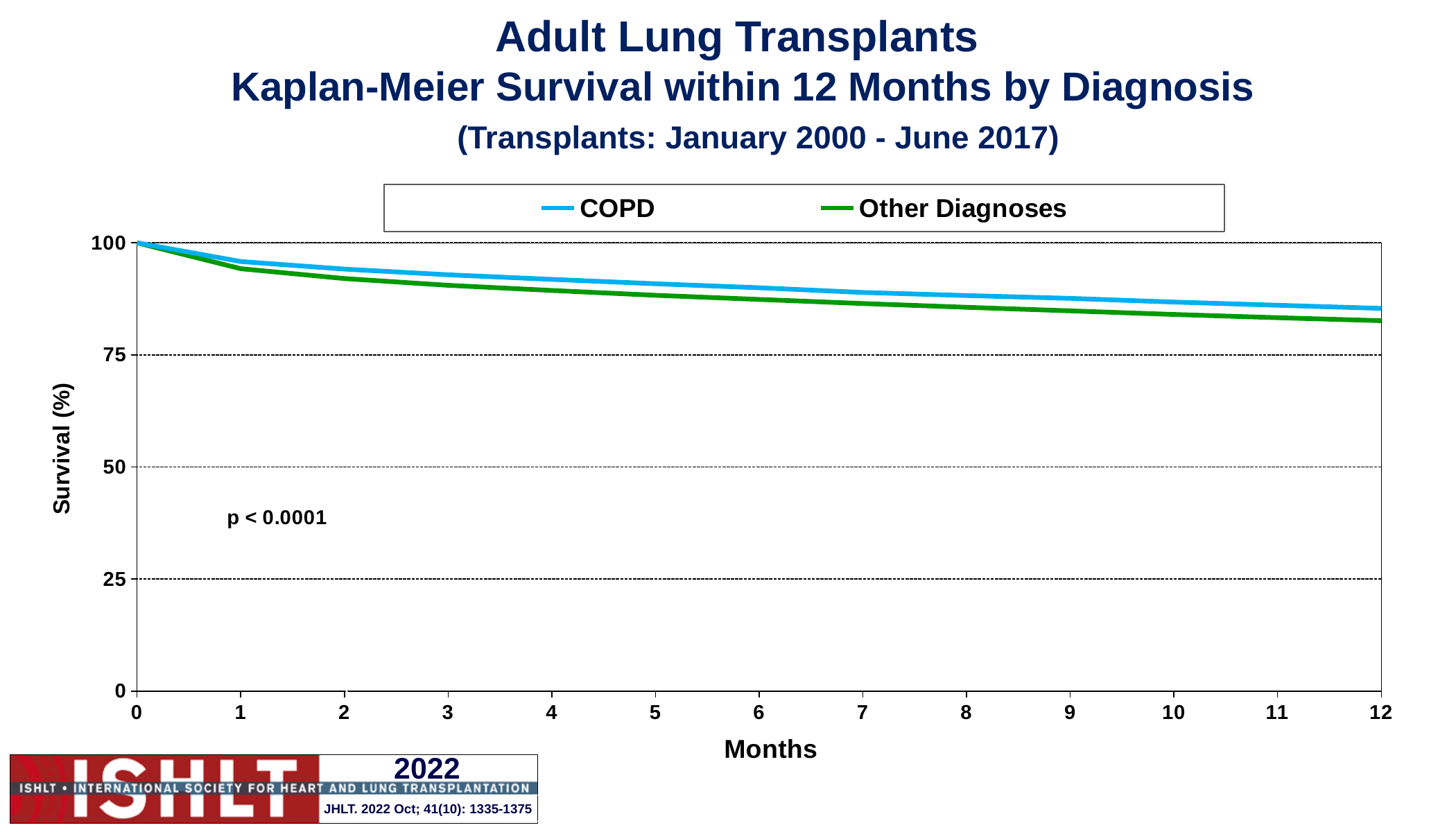
Which series has the lower survival at 6 months? Other Diagnoses At 12 months, which series has the higher survival, COPD or Other Diagnoses? COPD Which two series are shown in the legend? COPD and Other Diagnoses What p-value is printed on the chart? p < 0.0001 Is the survival for COPD at 12 months greater or less than 75? greater Is the survival for Other Diagnoses at 1 month greater or less than 100? less Is the survival for Other Diagnoses at 12 months greater or less than 75? greater What is the survival (%) for Other Diagnoses at 0 months? 100 Do the survival curves rise or fall as months increase? fall What is the survival (%) for COPD at 0 months? 100 How many series does the legend list? 2 What kind of chart is shown on the slide? line chart